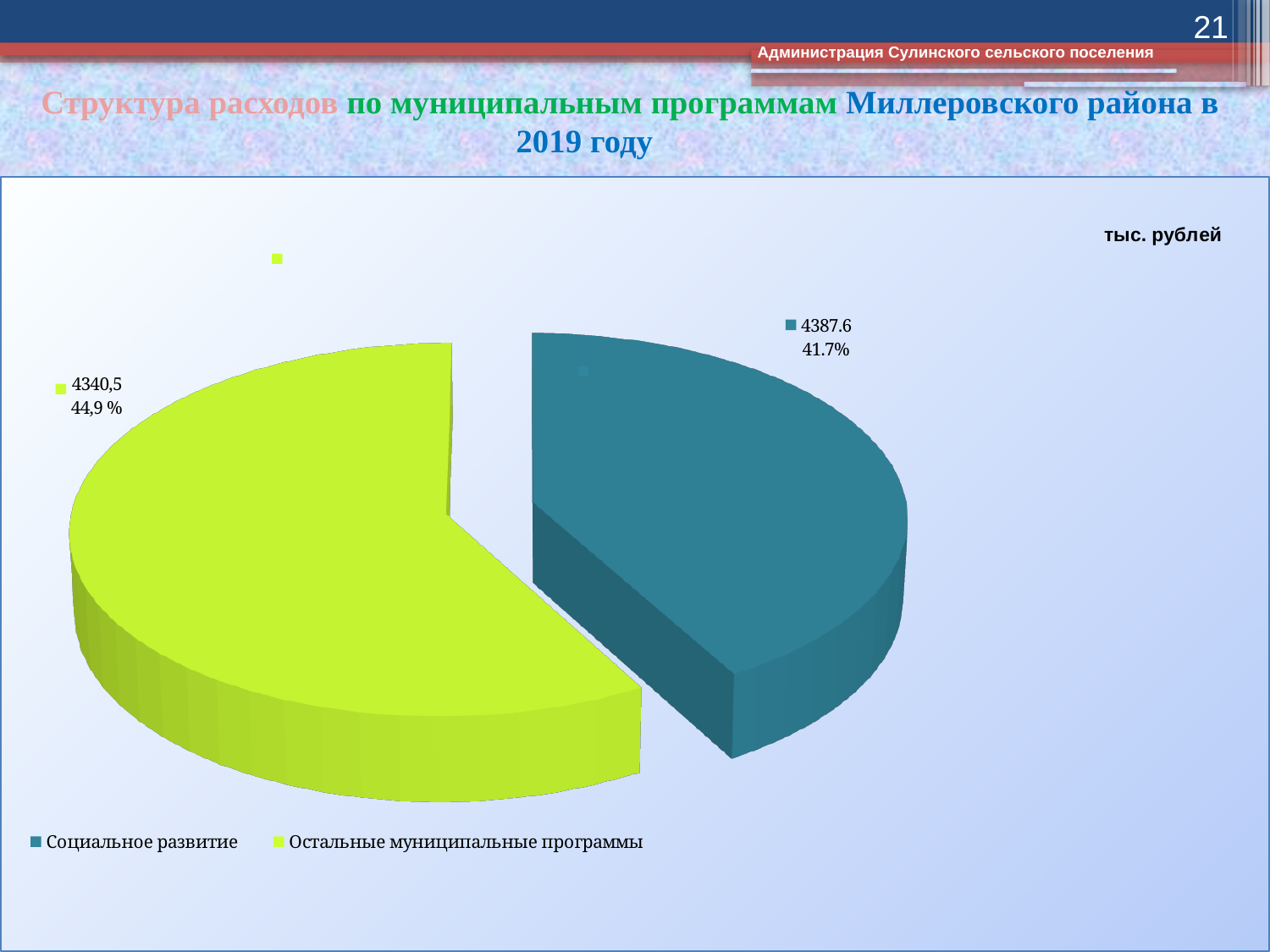
In what units are the values of the pie chart given, according to the label in the top right of the chart area? тыс. рублей Which slice of the pie chart is labelled with the percentage 41.7%? Социальное развитие Which legend entry is shown in teal (dark blue-green) on the pie chart? Социальное развитие How many slices does the pie chart have? 2 How many entries does the legend of the pie chart list? 2 What percentage is printed for the slice "Социальное развитие"? 41.7% What value is printed for the slice "Остальные муниципальные программы"? 4340,5 What kind of chart is shown on the slide? pie chart What percentage is printed for the slice "Остальные муниципальные программы"? 44,9 % What value is printed for the slice "Социальное развитие"? 4387.6